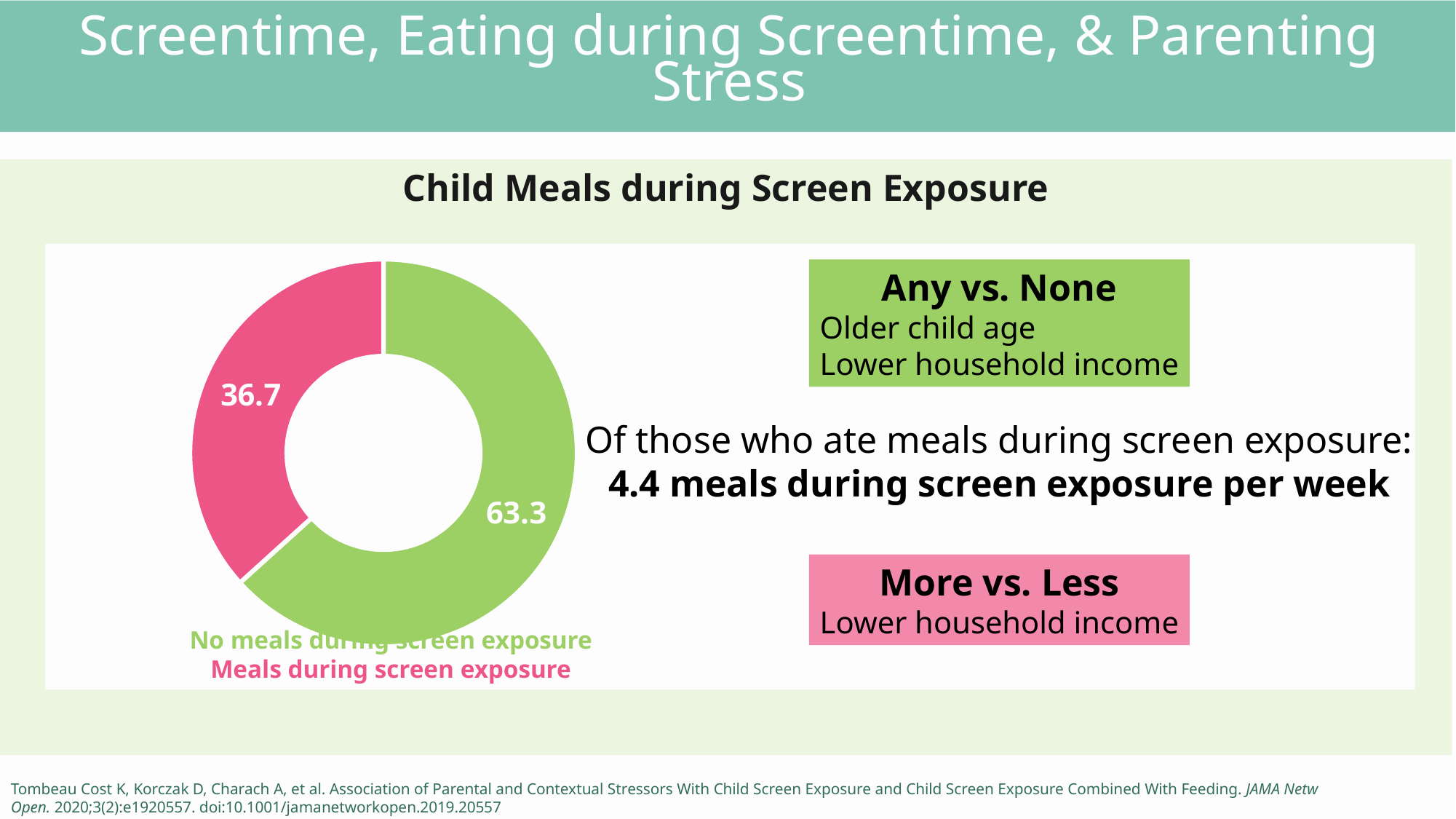
Which category has the smallest slice? Meals during screen exposure What is the title of the chart? Child Meals during Screen Exposure What is the total of the two slice values? 100 Which is larger: "No meals during screen exposure" or "Meals during screen exposure"? No meals during screen exposure What is the value for "Meals during screen exposure"? 36.7 What colour is the "Meals during screen exposure" slice? Pink How many slices does the chart have? 2 What is the value for "No meals during screen exposure"? 63.3 Which category has the largest slice? No meals during screen exposure What kind of chart is shown on the slide? Doughnut (pie) chart What is the difference between the "No meals during screen exposure" and "Meals during screen exposure" values? 26.6 How many entries does the legend list? 2